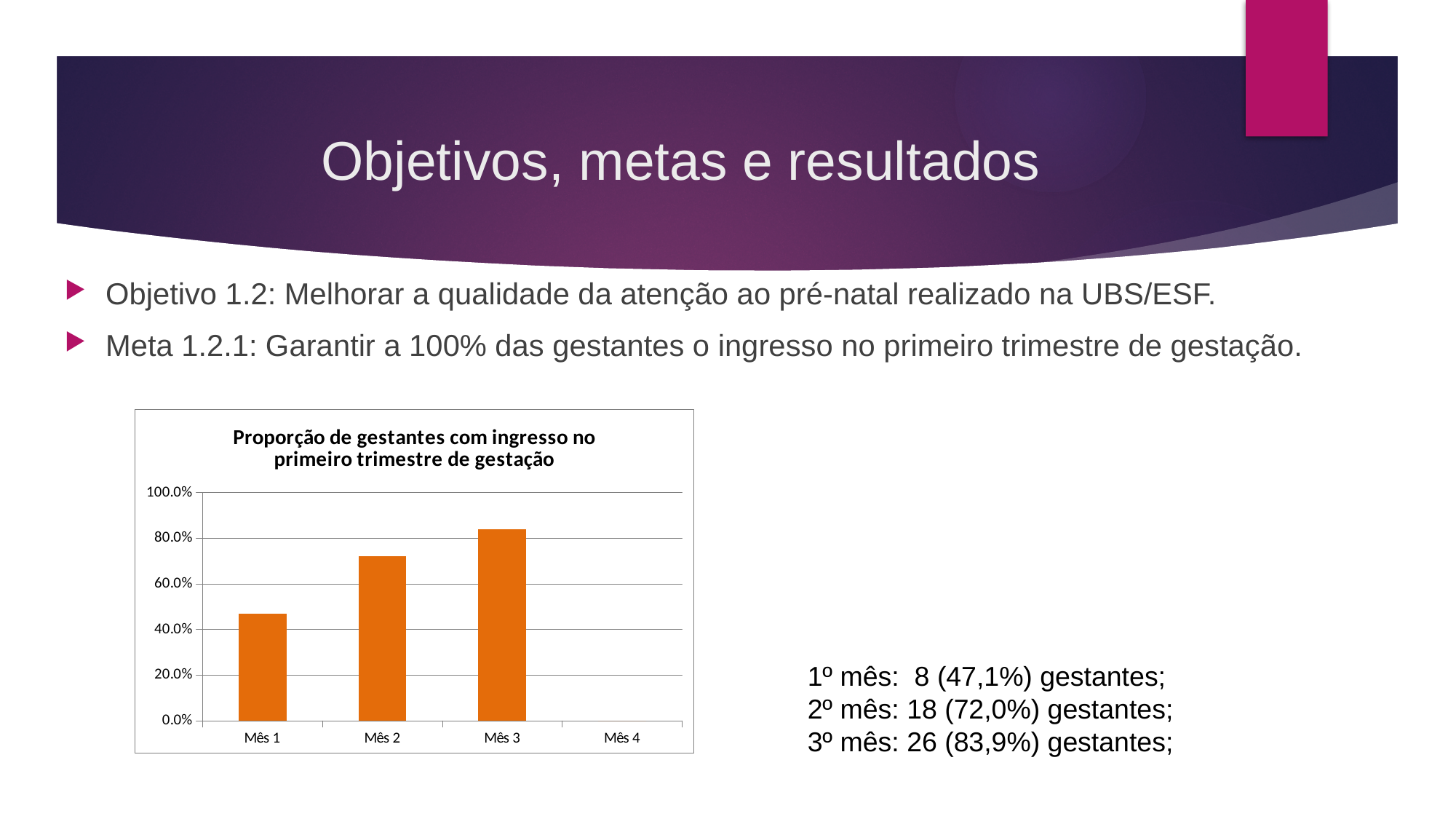
According to the text beside the chart, what proportion of pregnant women entered in the first trimester in the 3º mês? 83,9% Is the value for Mês 3 greater or less than 80.0%? greater Is the value for Mês 1 greater or less than 60.0%? less Is the value for Mês 2 greater or less than 60.0%? greater Which month has the lowest value in the chart? Mês 4 Which is larger, the value for Mês 2 or the value for Mês 3? Mês 3 Do the values rise or fall from Mês 1 to Mês 3? rise What kind of chart is shown on the slide? bar chart What is the title of the chart? Proporção de gestantes com ingresso no primeiro trimestre de gestação How many month categories are shown on the x axis of the chart? 4 Which month has the highest bar in the chart? Mês 3